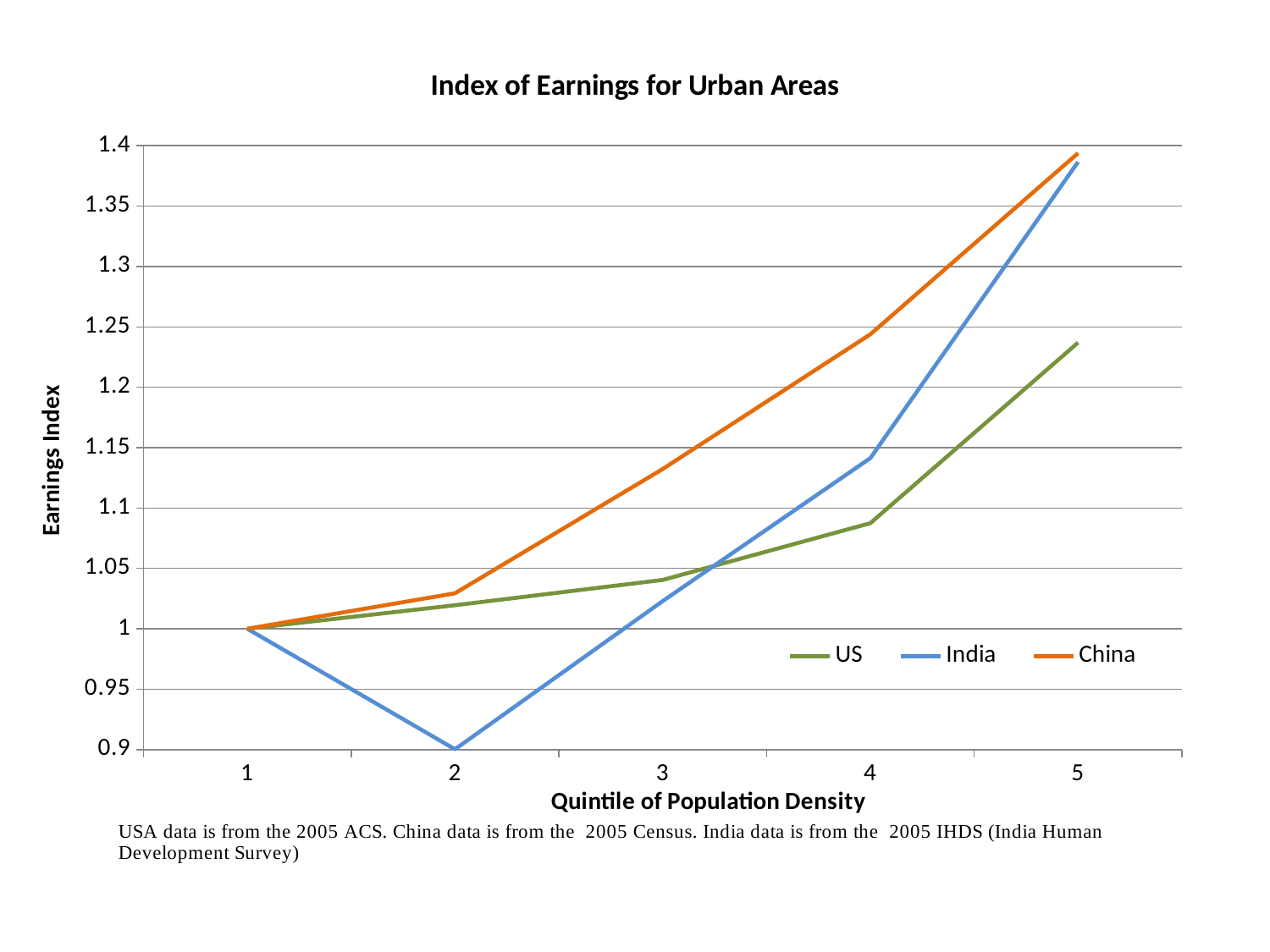
How many series does the legend list? 3 Which series has the lowest earnings index at quintile 5? US Which series has the lowest earnings index at quintile 2? India Which series has the highest earnings index at quintile 4? China What is the earnings index for India at quintile 2? 0.9 What kind of chart is shown on the slide? line chart Does the earnings index for China rise or fall from quintile 1 to quintile 5? rise Is the earnings index for US at quintile 5 greater or less than 1.25? less At quintile 4, is the earnings index larger for India or for US? India Is the earnings index for China at quintile 4 greater or less than 1.2? greater What is the earnings index for China at quintile 1? 1 How many quintiles are plotted along the x axis? 5